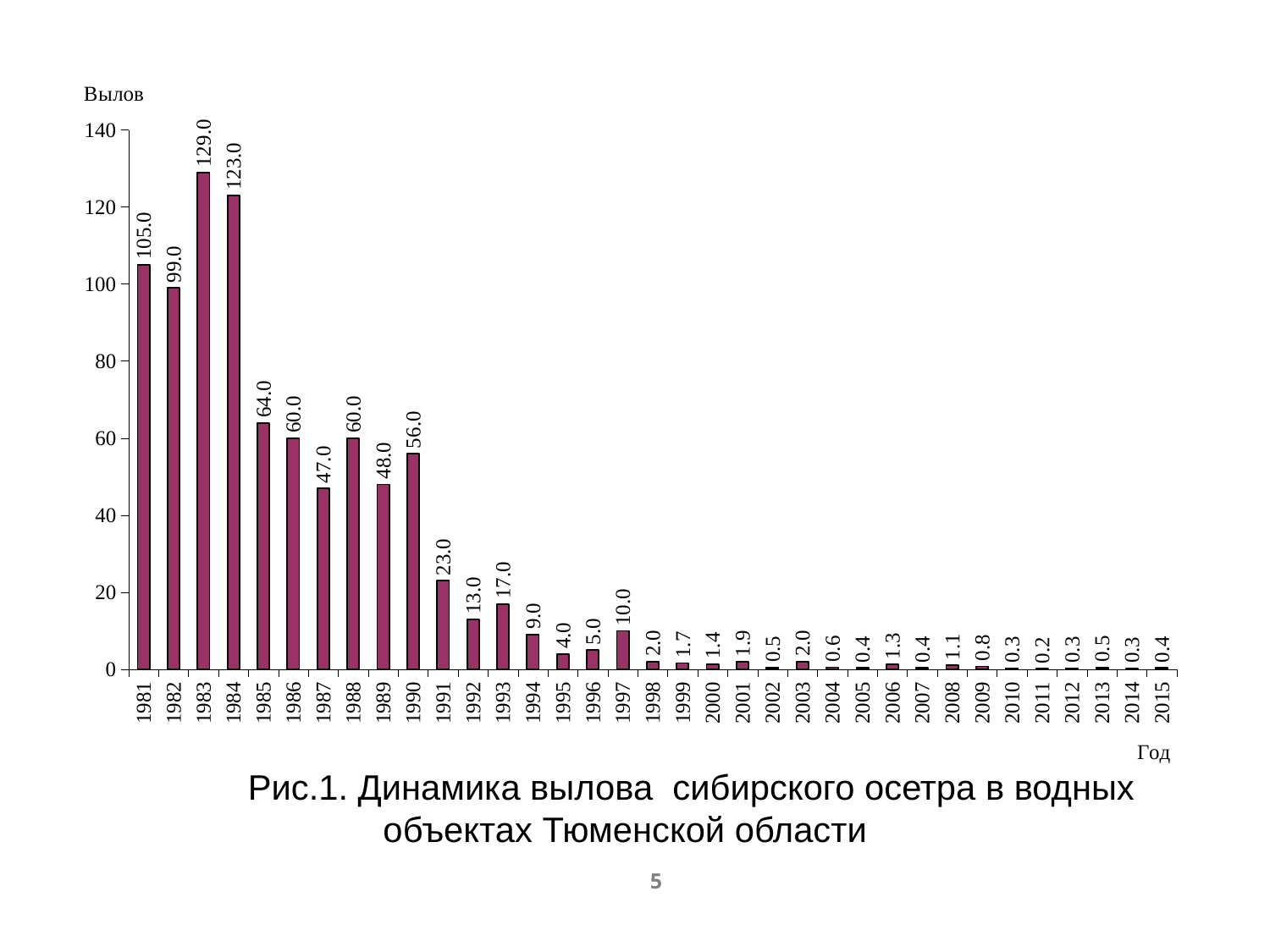
Which year has the highest value? 1983 Which is larger, the value for 1992 or the value for 1993? 1993 How many years are shown on the x axis? 35 What is the difference between the values for 1985 and 1987? 17.0 Is the value for 1981 greater or less than 100? greater Do the values generally rise or fall from 1983 to 2015? Fall What is the value for 1983? 129.0 What is the difference between the values for 1983 and 1984? 6.0 Which year has the lowest value? 2011 What kind of chart is this? Bar chart What is the value for 1991? 23.0 What is the value for 2006? 1.3